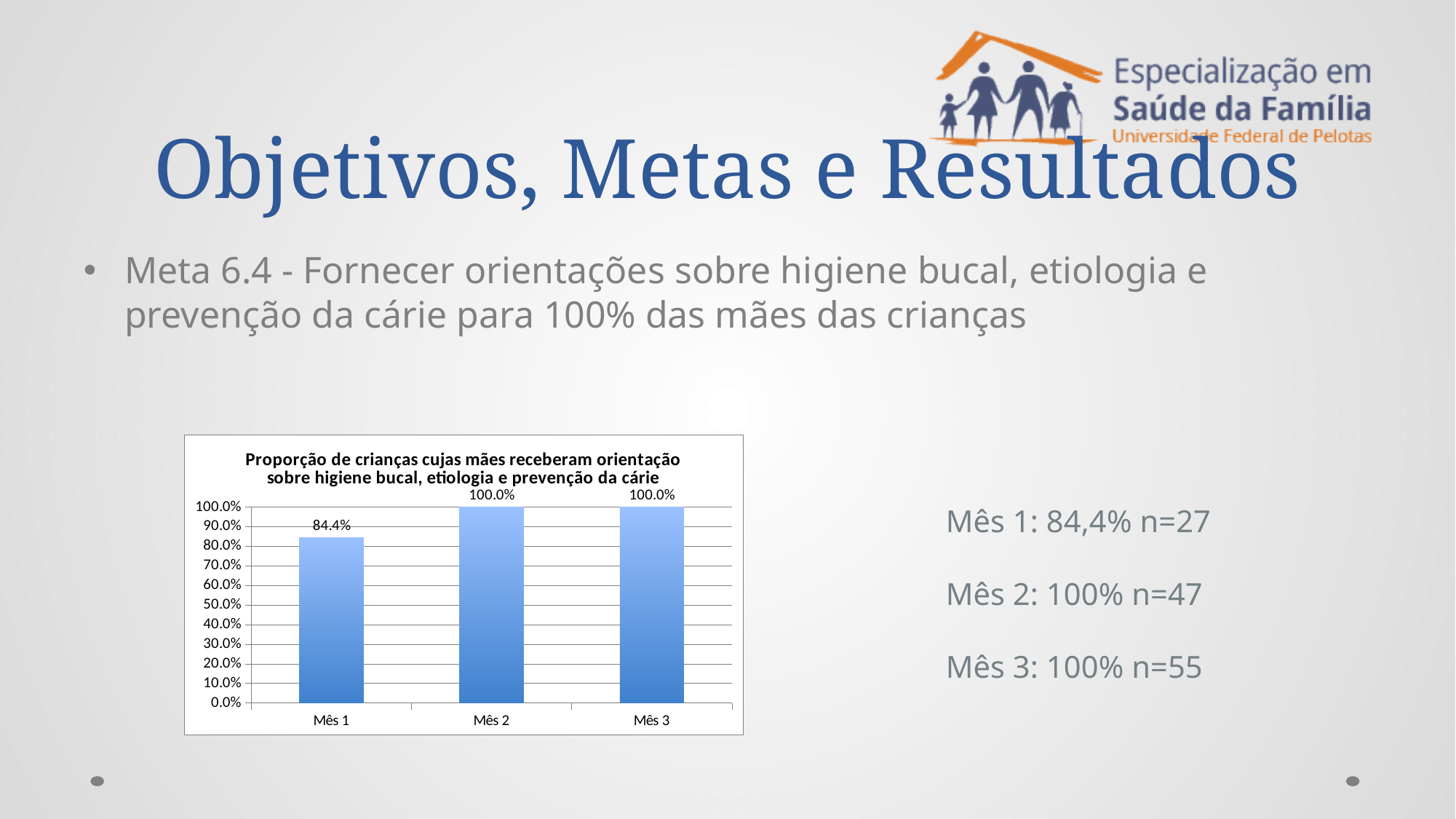
How many categories are shown on the x axis? 3 What is the difference between the values for Mês 2 and Mês 1? 15.6% Which is larger, the value for Mês 1 or the value for Mês 3? Mês 3 Which category has the lowest value? Mês 1 What kind of chart is shown on the slide? bar chart What is the highest tick value shown on the y axis? 100.0% What is the value for Mês 3? 100.0% Do the values rise or fall from Mês 1 to Mês 2? rise What is the value for Mês 2? 100.0% What is the title of the chart? Proporção de crianças cujas mães receberam orientação sobre higiene bucal, etiologia e prevenção da cárie Is the value for Mês 1 greater or less than 90.0%? less What is the value for Mês 1? 84.4%